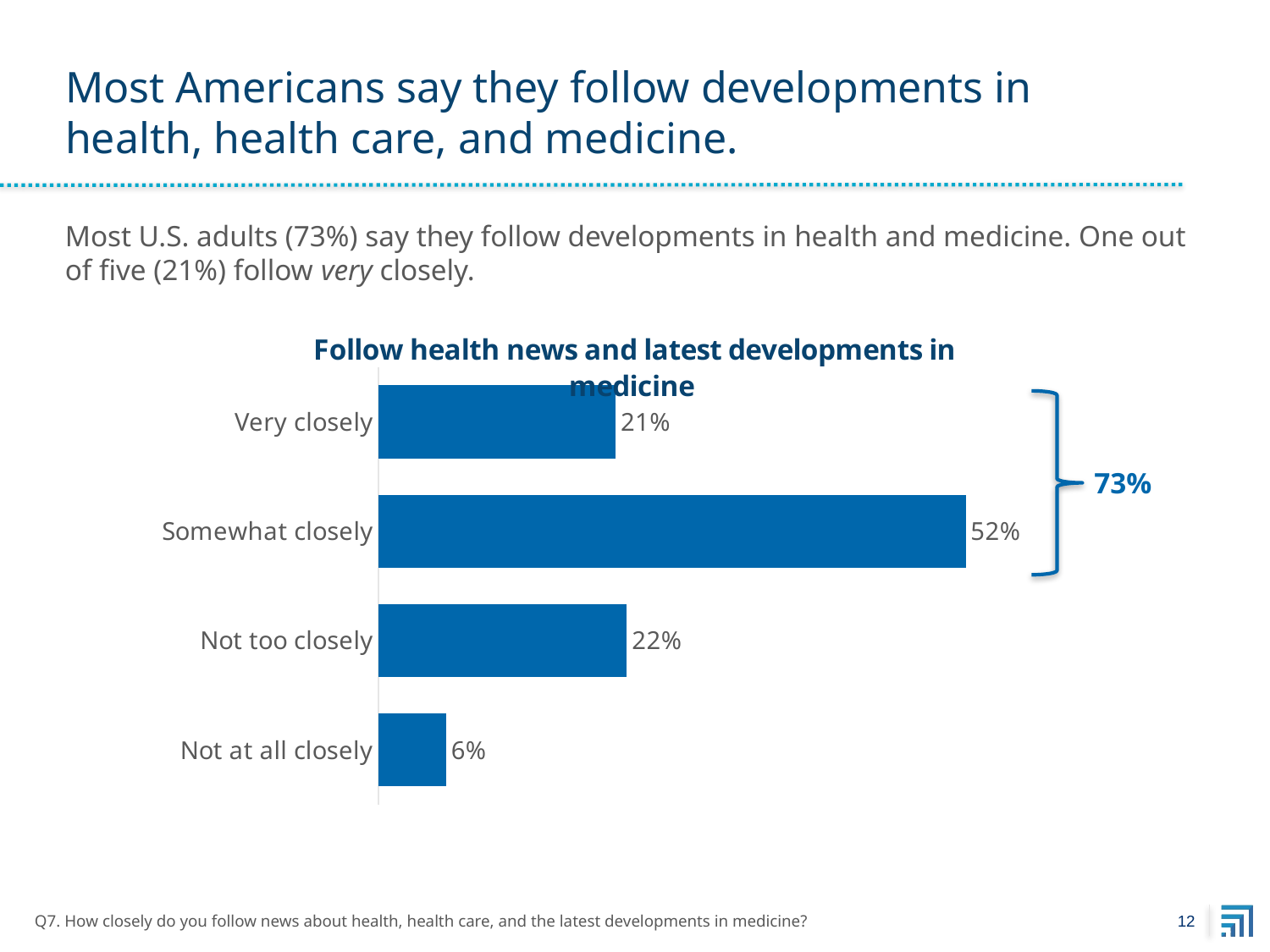
Which category has the highest value? Somewhat closely What is the value for 'Not at all closely'? 6% How many categories are shown in the chart? 4 What is the value shown for 'Somewhat closely'? 52% What percentage is shown for 'Not too closely'? 22% What combined percentage does the bracket beside the 'Very closely' and 'Somewhat closely' bars indicate? 73% What is the title of the chart? Follow health news and latest developments in medicine Which category has the lowest value? Not at all closely Which is larger, the value for 'Not too closely' or the value for 'Not at all closely'? Not too closely What is the difference between the 'Somewhat closely' and 'Very closely' values? 31% What kind of chart is shown on the slide? Bar chart What percentage of respondents say they follow health news 'Very closely'? 21%